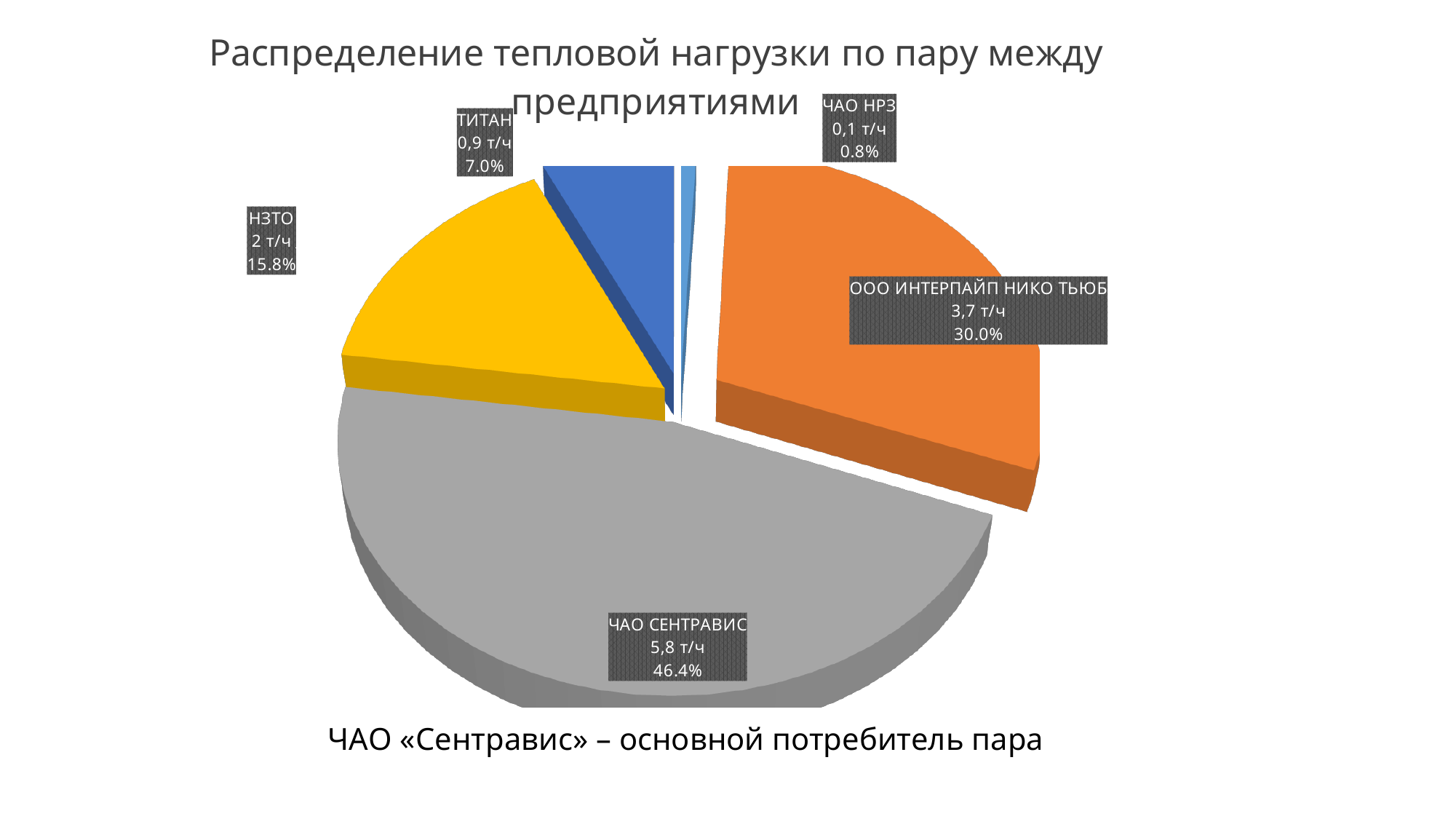
Which enterprise has the largest share of the steam load? ЧАО СЕНТРАВИС What share of the pie does ООО ИНТЕРПАЙП НИКО ТЬЮБ represent? 30.0% Which is larger, the steam load for ТИТАН or for НЗТО? НЗТО How many slices does the pie chart have? 5 What is the steam load value for НЗТО? 2 т/ч What is the steam load value for ООО ИНТЕРПАЙП НИКО ТЬЮБ? 3,7 т/ч What is the steam load value for ТИТАН? 0,9 т/ч Which enterprise has the smallest share of the steam load? ЧАО НРЗ What is the steam load value for ЧАО НРЗ? 0,1 т/ч What is the steam load value for ЧАО СЕНТРАВИС? 5,8 т/ч What kind of chart is shown on the slide? Pie chart What share of the pie does НЗТО represent? 15.8%